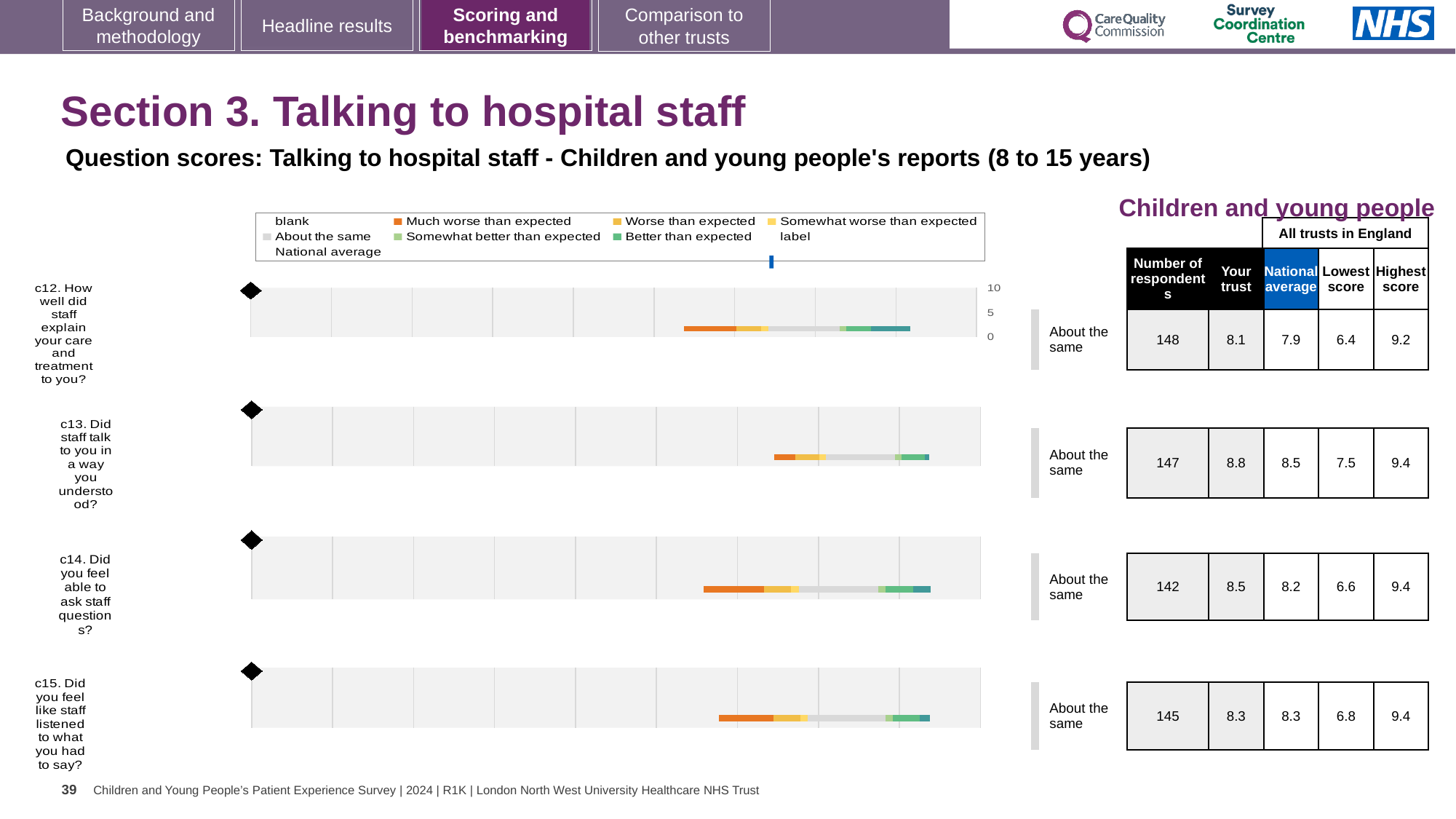
What is the difference between the 'Your trust' score and the national average for question c14? 0.3 What benchmark category is shown for question c15 (Did you feel like staff listened to what you had to say?)? About the same How many survey questions are plotted on this slide? 4 What is the highest score among all trusts in England for question c15 (Did you feel like staff listened to what you had to say?)? 9.4 What kind of chart is used to show the benchmarking ranges for each question? bar chart Which of the four questions (c12 to c15) has the lowest 'Your trust' score? c12. How well did staff explain your care and treatment to you? How many respondents answered question c14 (Did you feel able to ask staff questions?)? 142 What is the 'Your trust' score for question c12 (How well did staff explain your care and treatment to you?)? 8.1 What is the national average score for question c13 (Did staff talk to you in a way you understood?)? 8.5 What is the lowest score among all trusts in England for question c12? 6.4 Which of the four questions (c12 to c15) has the highest 'Your trust' score? c13. Did staff talk to you in a way you understood? Is the 'Your trust' score for question c12 higher or lower than the national average for that question? higher